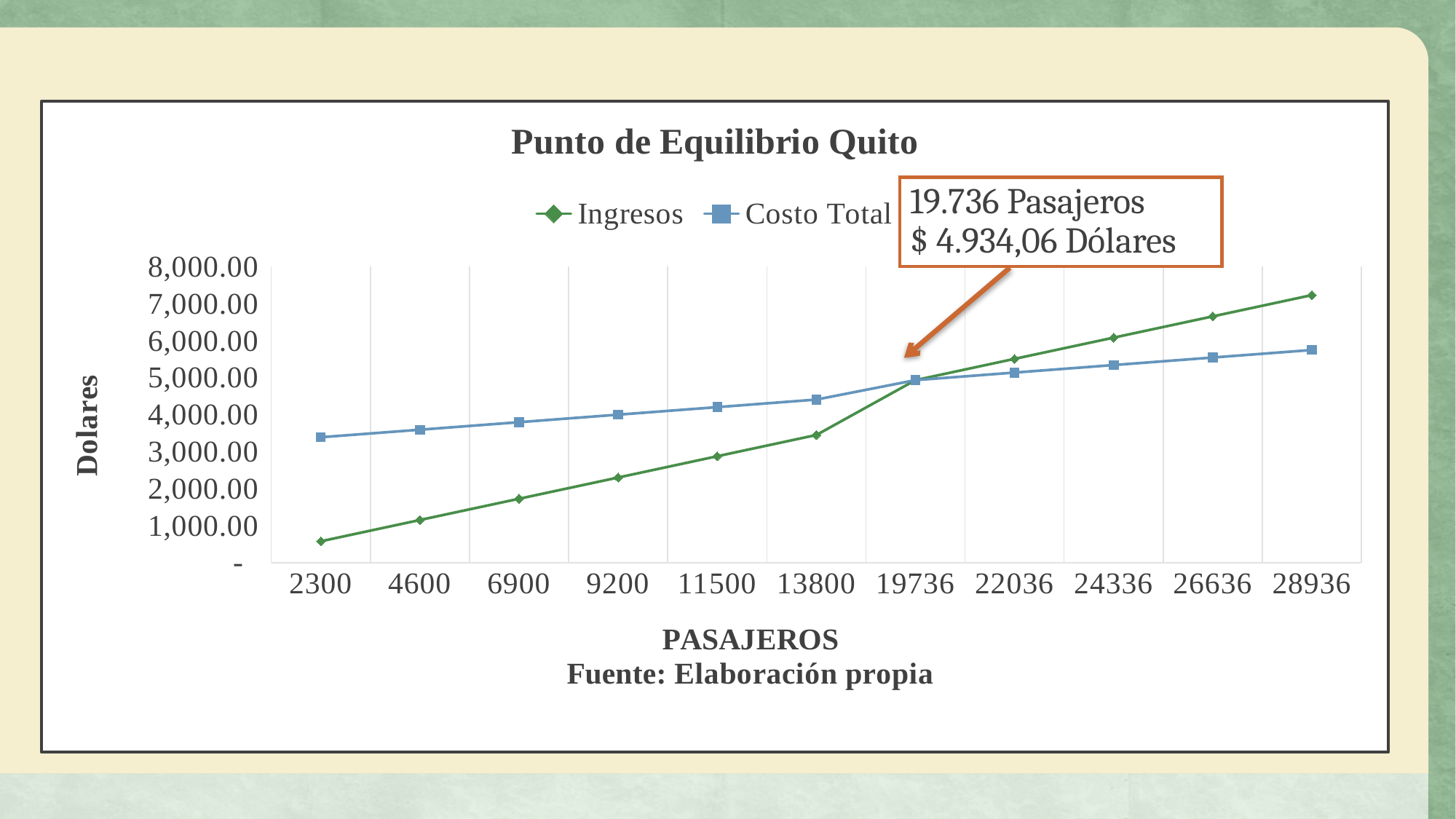
Do the Ingresos values rise or fall as the number of passengers increases along the x axis? rise Is the Costo Total value at 2300 passengers greater or less than 3,000.00? greater Is the Ingresos value at 28936 passengers greater or less than 7,000.00? greater How many passenger categories are shown on the x axis? 11 What kind of chart is shown on the slide? line chart At 28936 passengers, which series has the larger value, Ingresos or Costo Total? Ingresos Is the Costo Total value at 28936 passengers greater or less than 6,000.00? less At 2300 passengers, which series has the larger value, Ingresos or Costo Total? Costo Total What is the title of the chart? Punto de Equilibrio Quito According to the annotation box, at how many passengers is the break-even point reached? 19.736 Pasajeros How many series does the legend list? 2